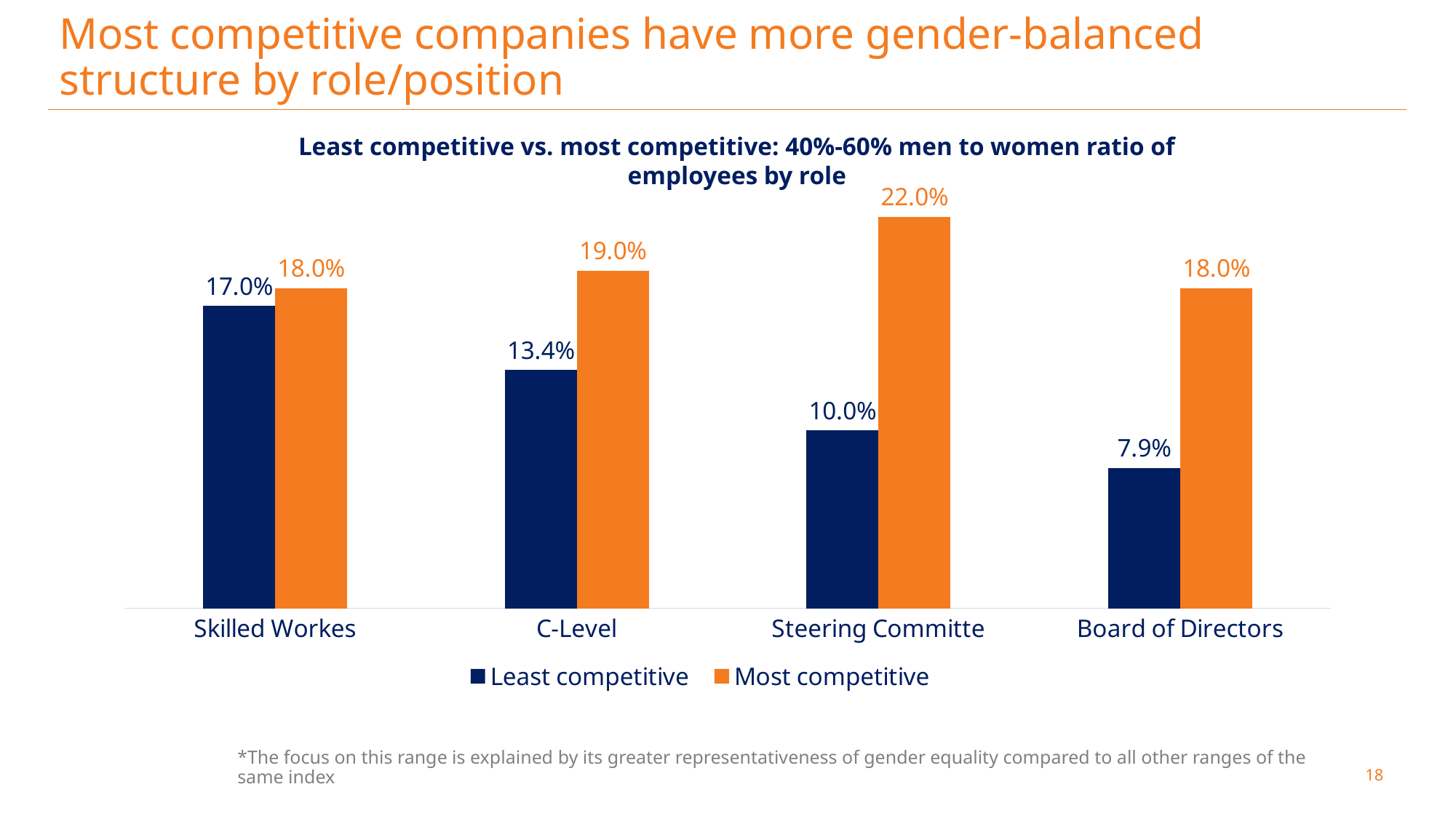
Which category has the highest value for the Most competitive series? Steering Committe Do the Least competitive values rise or fall from Skilled Workes to Board of Directors? Fall What is the value for Most competitive in the Steering Committe category? 22.0% Which category has the lowest value for the Least competitive series? Board of Directors What is the value for Least competitive in the C-Level category? 13.4% What is the value for Least competitive in the Board of Directors category? 7.9% What is the difference between the Most competitive and Least competitive values for Steering Committe? 12.0% How many series does the legend list? 2 How many categories are shown on the x axis of the chart? 4 What is the difference between the Most competitive and Least competitive values for Board of Directors? 10.1% What kind of chart is shown on the slide? Bar chart Which is larger for Skilled Workes: the Least competitive value or the Most competitive value? Most competitive